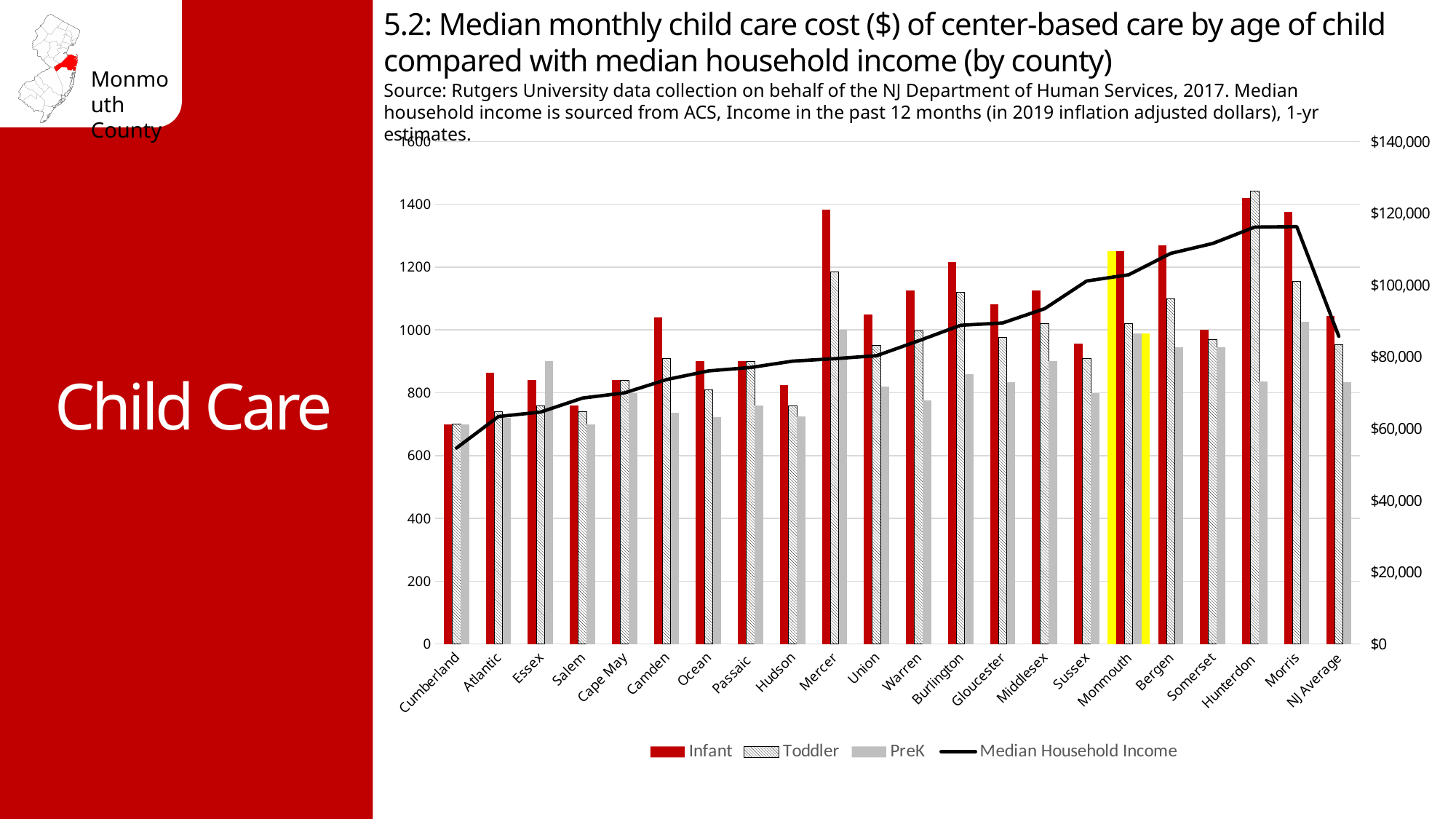
Is the Infant value for Cumberland greater or less than 800? less Is the Infant value for Mercer greater or less than 1200? greater Is the Median Household Income for Morris greater or less than $100,000? greater Which category has the highest Infant bar? Hunterdon How many counties/categories are shown along the x axis? 22 Which is larger, the Infant value for Mercer or the Infant value for Union? Mercer Which category has the lowest Infant bar? Cumberland Which county's bars are highlighted in yellow? Monmouth How many series does the legend list? 4 Which category has the highest Toddler bar? Hunterdon What kind of chart is shown on the slide? Bar chart with a line series